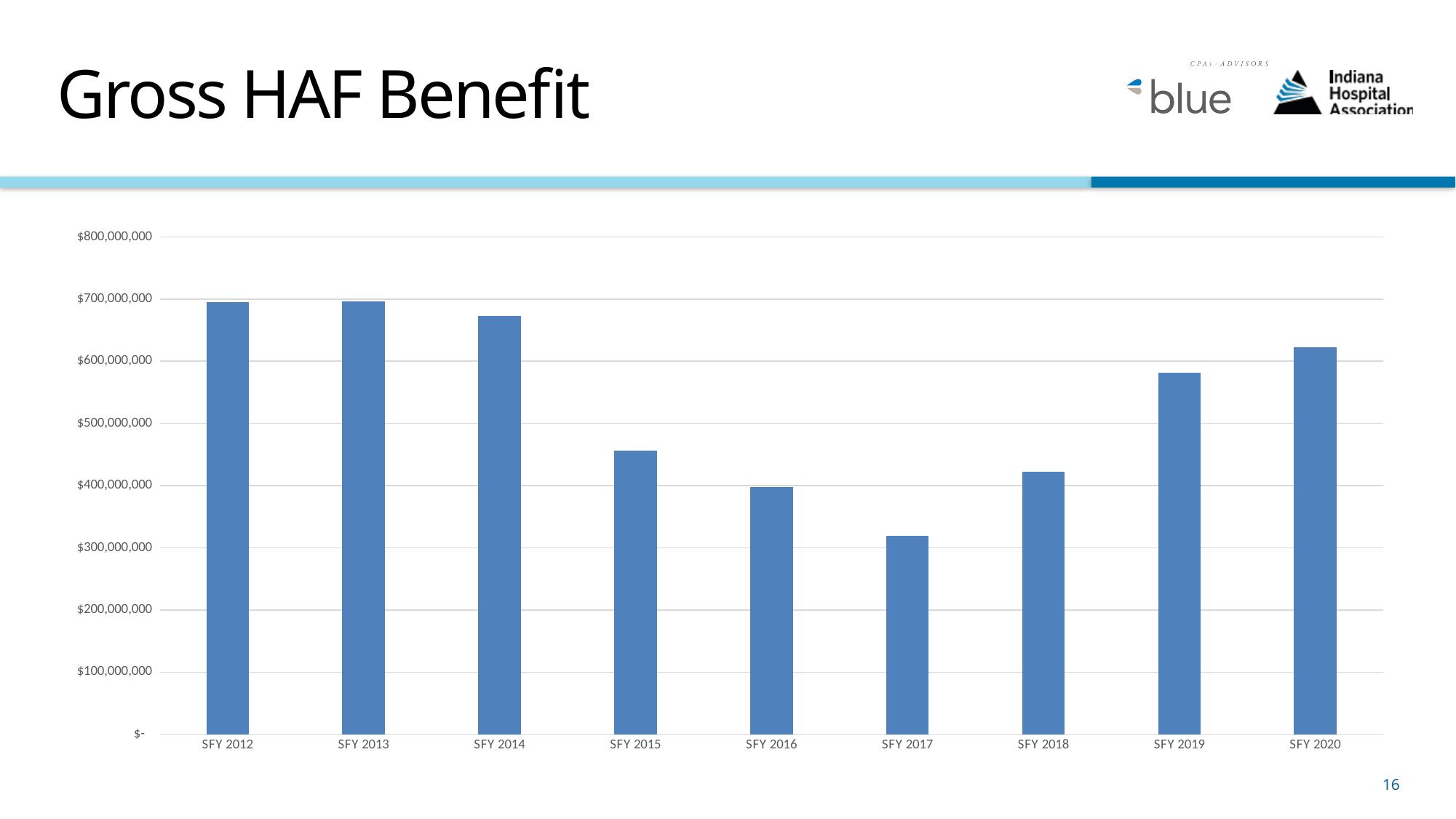
How many fiscal years are plotted on the chart? 9 Which fiscal year has the lowest Gross HAF Benefit? SFY 2017 What kind of chart is shown on the slide? Bar chart Is the value for SFY 2017 greater or less than $400,000,000? less Which is larger, the value for SFY 2019 or the value for SFY 2020? SFY 2020 Is the value for SFY 2020 greater or less than $600,000,000? greater Is the value for SFY 2019 greater or less than $600,000,000? less What is the title of the chart on the slide? Gross HAF Benefit Which is larger, the value for SFY 2015 or the value for SFY 2016? SFY 2015 Do the values rise or fall from SFY 2014 to SFY 2017? fall